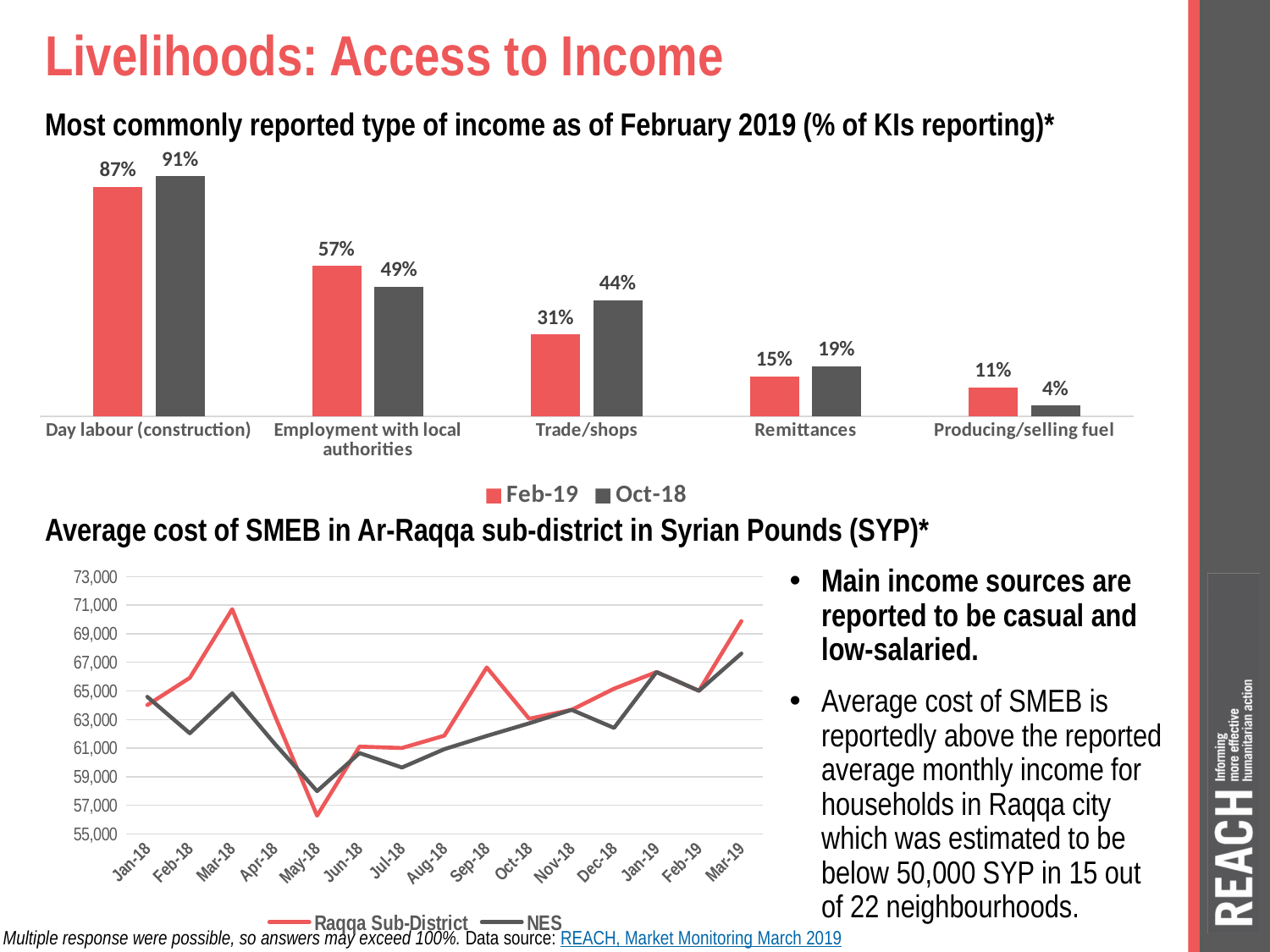
How many income types are shown in the 'Most commonly reported type of income' chart? 5 In the 'Average cost of SMEB in Ar-Raqqa sub-district' chart, which two series does the legend list? Raqqa Sub-District and NES In the 'Most commonly reported type of income' chart, what is the Oct-18 value for Producing/selling fuel? 4% How many series does the legend of the 'Most commonly reported type of income' chart list? 2 In the 'Most commonly reported type of income' chart, what is the Feb-19 value for Day labour (construction)? 87% In the 'Most commonly reported type of income' chart, what is the Oct-18 value for Trade/shops? 44% What kind of chart is the 'Average cost of SMEB in Ar-Raqqa sub-district' chart? Line chart In the 'Most commonly reported type of income' chart, what is the difference between the Feb-19 and Oct-18 values for Employment with local authorities? 8% In the 'Most commonly reported type of income' chart, which income type has the highest Feb-19 value? Day labour (construction) In the 'Average cost of SMEB in Ar-Raqqa sub-district' chart, is the Raqqa Sub-District value for May-18 greater or less than 59,000? less In the 'Most commonly reported type of income' chart, which income type has the lowest Oct-18 value? Producing/selling fuel In the 'Most commonly reported type of income' chart, which is larger for Remittances: the Feb-19 value or the Oct-18 value? Oct-18